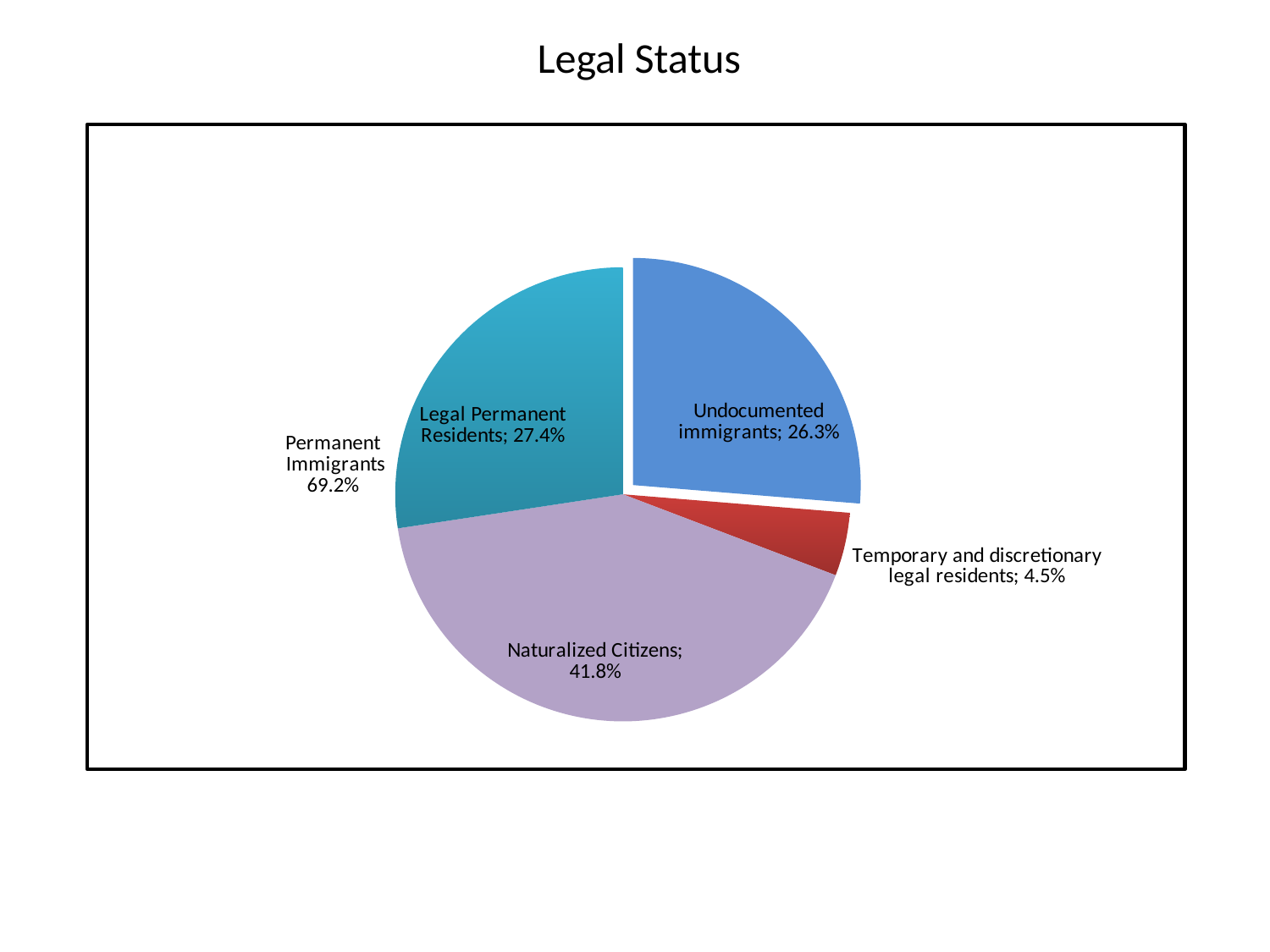
What percentage of the pie is Undocumented immigrants? 26.3% Which is larger, Legal Permanent Residents or Undocumented immigrants? Legal Permanent Residents How many slices does the pie chart have? 4 Which slice of the pie is the smallest? Temporary and discretionary legal residents What is the title of the chart? Legal Status What percentage of the pie is Naturalized Citizens? 41.8% What is the difference in percentage points between Naturalized Citizens and Undocumented immigrants? 15.5 What percentage of the pie is Legal Permanent Residents? 27.4% What type of chart is shown on the slide? pie chart What percentage is shown for Permanent Immigrants in the label outside the pie? 69.2% Which slice of the pie is the largest? Naturalized Citizens What percentage of the pie is Temporary and discretionary legal residents? 4.5%